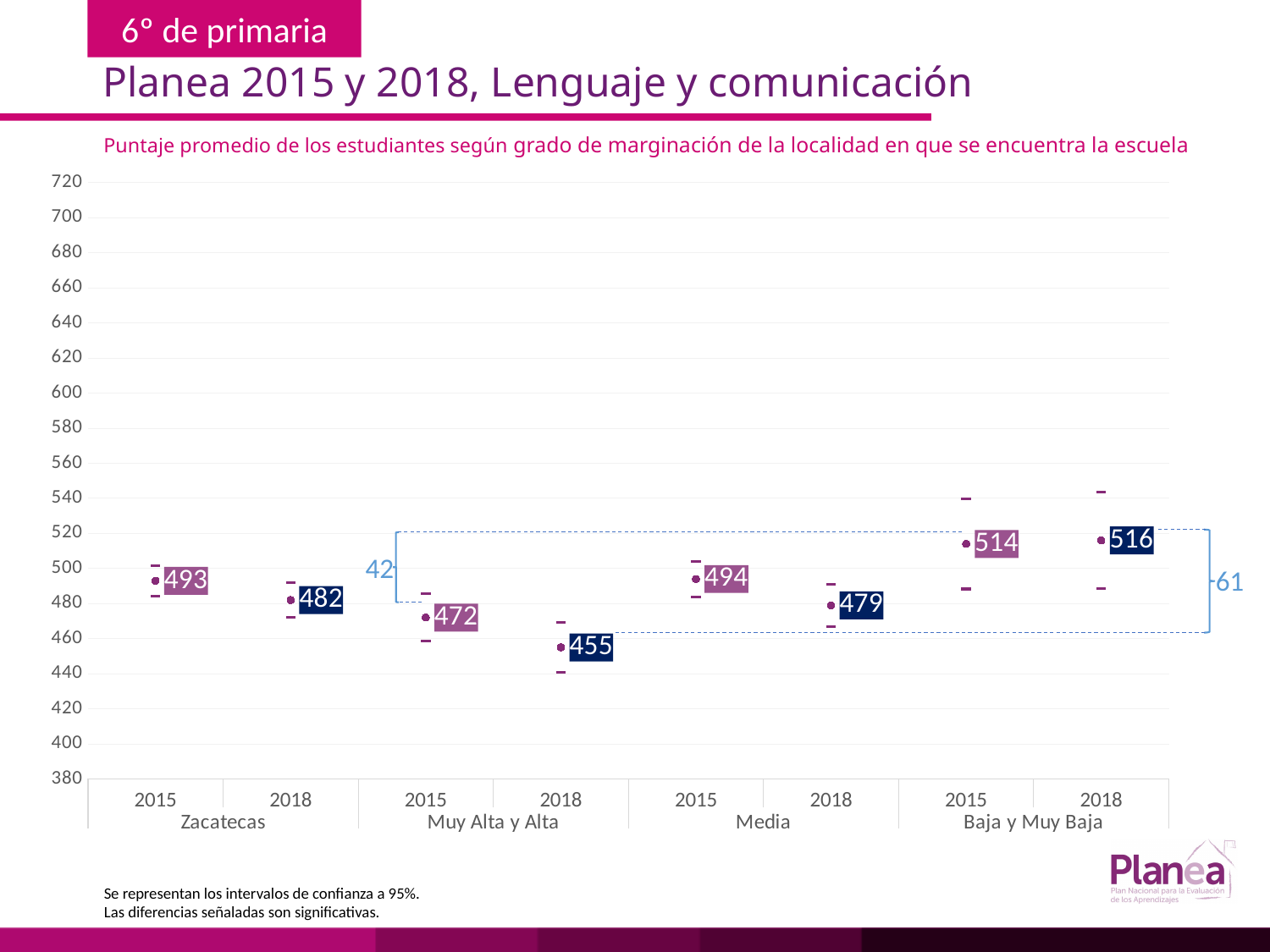
Did the average score for Zacatecas rise or fall from 2015 to 2018? Fall What is the 2015 average score for Zacatecas? 493 What is the difference between the 2015 and 2018 average scores for Zacatecas? 11 What is the 2018 average score for the Muy Alta y Alta marginación group? 455 Which is larger, the 2015 score for Muy Alta y Alta or the 2015 score for Media? Media (494) What is the 2015 average score for the Baja y Muy Baja marginación group? 514 What is the 2018 average score for the Media marginación group? 479 Which group and year has the lowest average score on the chart? Muy Alta y Alta, 2018 (455) Which group and year has the highest average score on the chart? Baja y Muy Baja, 2018 (516) How many data points (group-year combinations) are plotted on the chart? 8 What is the difference between the 2015 and 2018 average scores for the Media group? 15 What difference is indicated by the annotation between the 2018 scores of Muy Alta y Alta and Baja y Muy Baja? 61